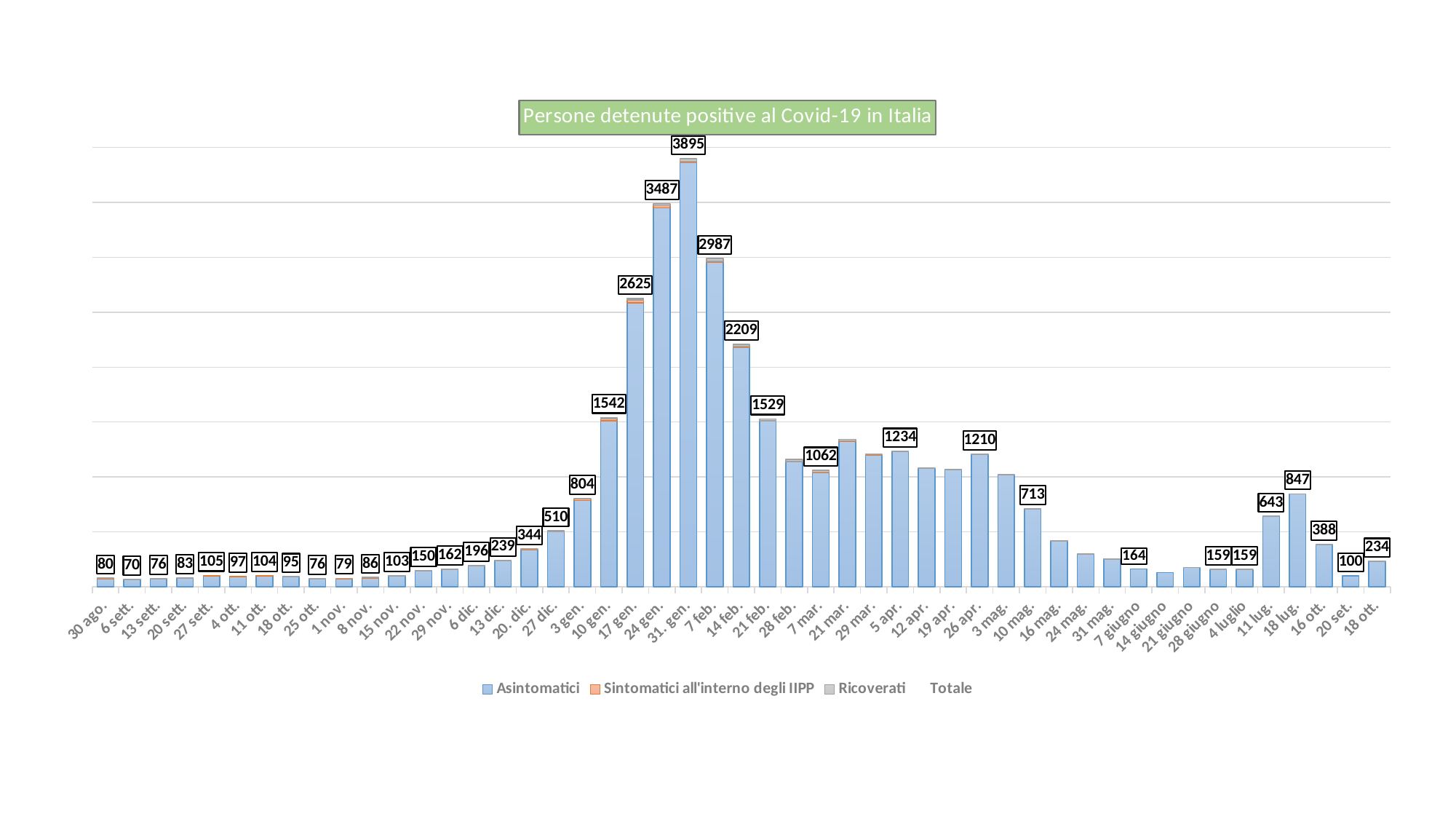
Which date has the lowest labelled total? 6 sett. Which is larger, the total for 7 feb. or the total for 14 feb.? 7 feb. Which date has the highest total of positive detainees? 31 gen. What is the total value labelled for 31 gen.? 3895 What kind of chart is shown on the slide? bar chart What is the total value labelled for 18 ott. (the last bar)? 234 What is the title of the chart? Persone detenute positive al Covid-19 in Italia How many entries does the legend list? 4 What is the difference between the totals for 31 gen. and 24 gen.? 408 What is the total value labelled for 18 lug.? 847 What is the total value labelled for 24 gen.? 3487 Do the totals rise or fall from 31 gen. to 21 feb.? fall